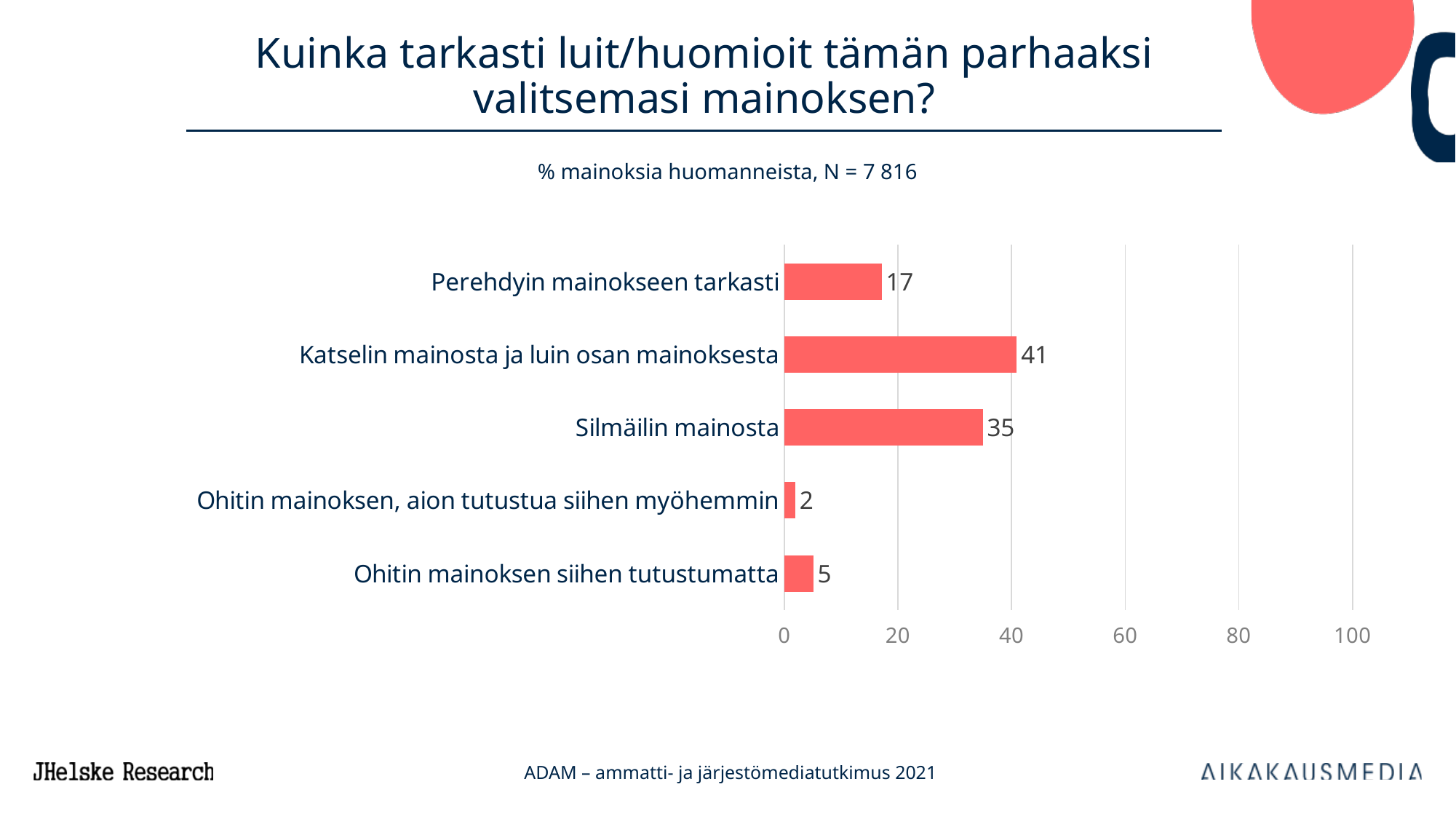
Which category has the lowest value? Ohitin mainoksen, aion tutustua siihen myöhemmin What is the difference between the values for "Katselin mainosta ja luin osan mainoksesta" and "Silmäilin mainosta"? 6 What is the value for "Ohitin mainoksen, aion tutustua siihen myöhemmin"? 2 How many categories are shown in the chart? 5 What is the value for "Ohitin mainoksen siihen tutustumatta"? 5 What is the value for "Silmäilin mainosta"? 35 Which is larger: the value for "Perehdyin mainokseen tarkasti" or "Ohitin mainoksen siihen tutustumatta"? Perehdyin mainokseen tarkasti What is the sample size (N) stated in the chart subtitle? 7 816 What is the value for "Katselin mainosta ja luin osan mainoksesta"? 41 Which category has the highest value? Katselin mainosta ja luin osan mainoksesta What kind of chart is shown on the slide? Bar chart What is the value for "Perehdyin mainokseen tarkasti"? 17